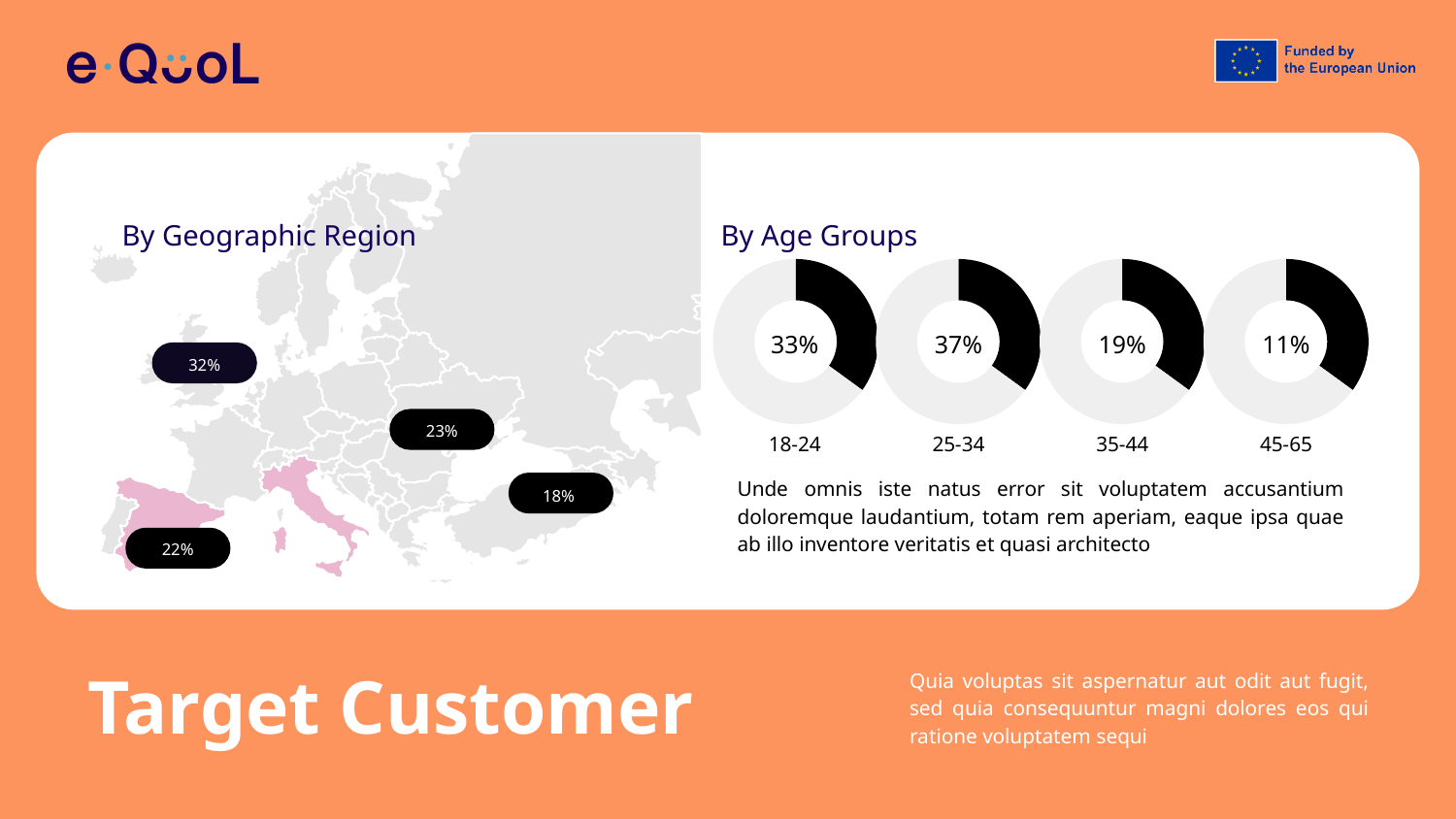
In the By Age Groups chart, which age group has the highest percentage? 25-34 What kind of chart is used for the By Age Groups section? Donut chart In the By Age Groups chart, what percentage is shown for the 45-65 age group? 11% How many age groups are shown in the By Age Groups chart? 4 In the By Age Groups chart, which has a larger percentage: the 18-24 group or the 35-44 group? 18-24 In the By Age Groups chart, what percentage is shown for the 35-44 age group? 19% In the By Age Groups chart, what percentage is shown for the 18-24 age group? 33% What is the highest percentage label shown on the By Geographic Region map? 32% How many percentage labels are shown on the By Geographic Region map? 4 In the By Age Groups chart, which age group has the lowest percentage? 45-65 In the By Age Groups chart, what is the difference between the percentages for the 25-34 and 35-44 age groups? 18% In the By Age Groups chart, what percentage is shown for the 25-34 age group? 37%